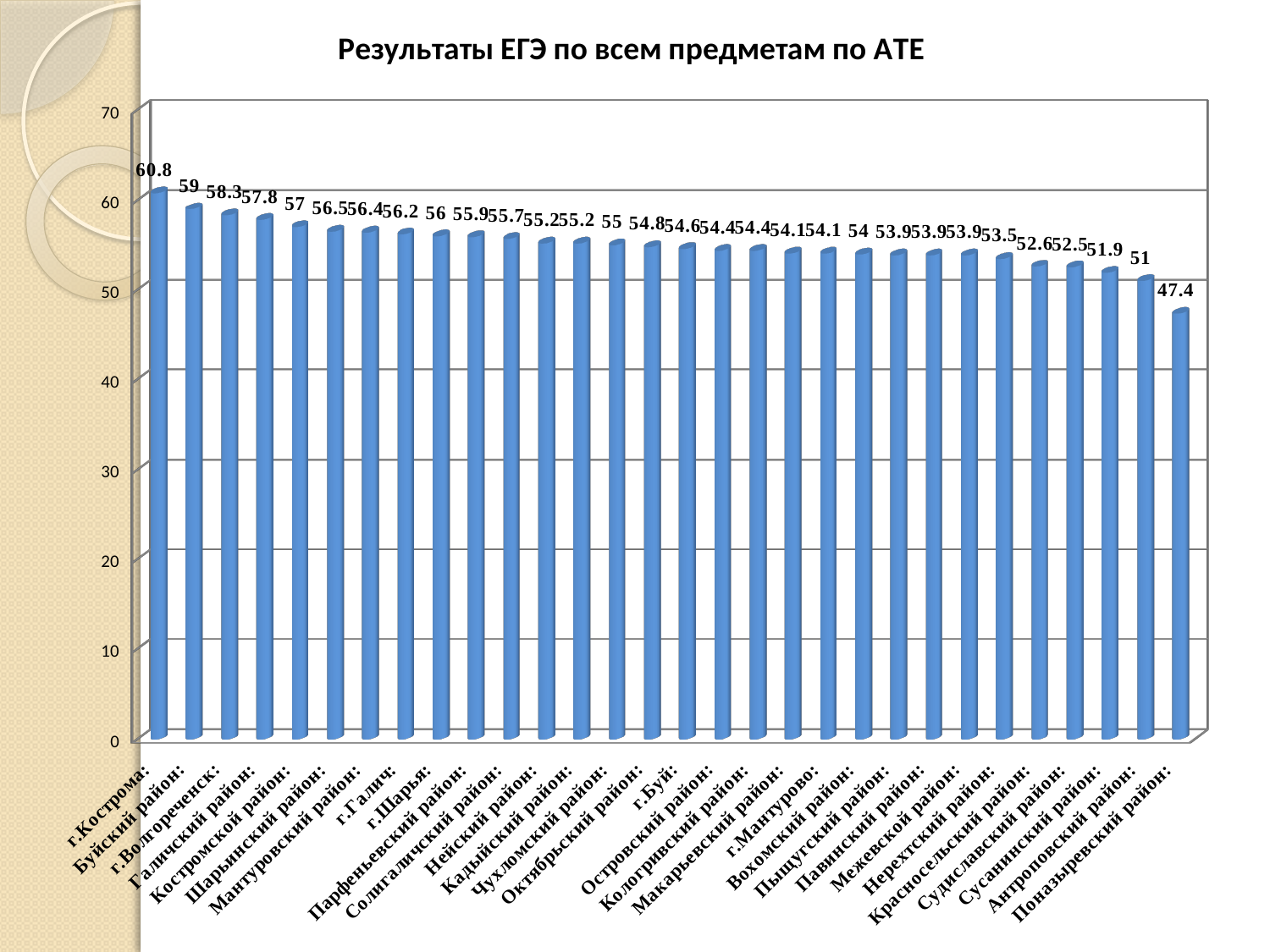
What is the value for Поназыревский район? 47.4 How many categories are plotted in the chart? 30 What is the difference between the values for г.Кострома and Поназыревский район? 13.4 What is the value for Буйский район? 59 Do the values rise or fall from left to right along the x axis? fall Which category has the highest value in the chart? г.Кострома Which category has the lowest value in the chart? Поназыревский район What is the value for г.Кострома? 60.8 Which is larger, the value for Буйский район or the value for Антроповский район? Буйский район What is the title of the chart? Результаты ЕГЭ по всем предметам по АТЕ What is the value for Антроповский район? 51 What kind of chart is shown on the slide? bar chart